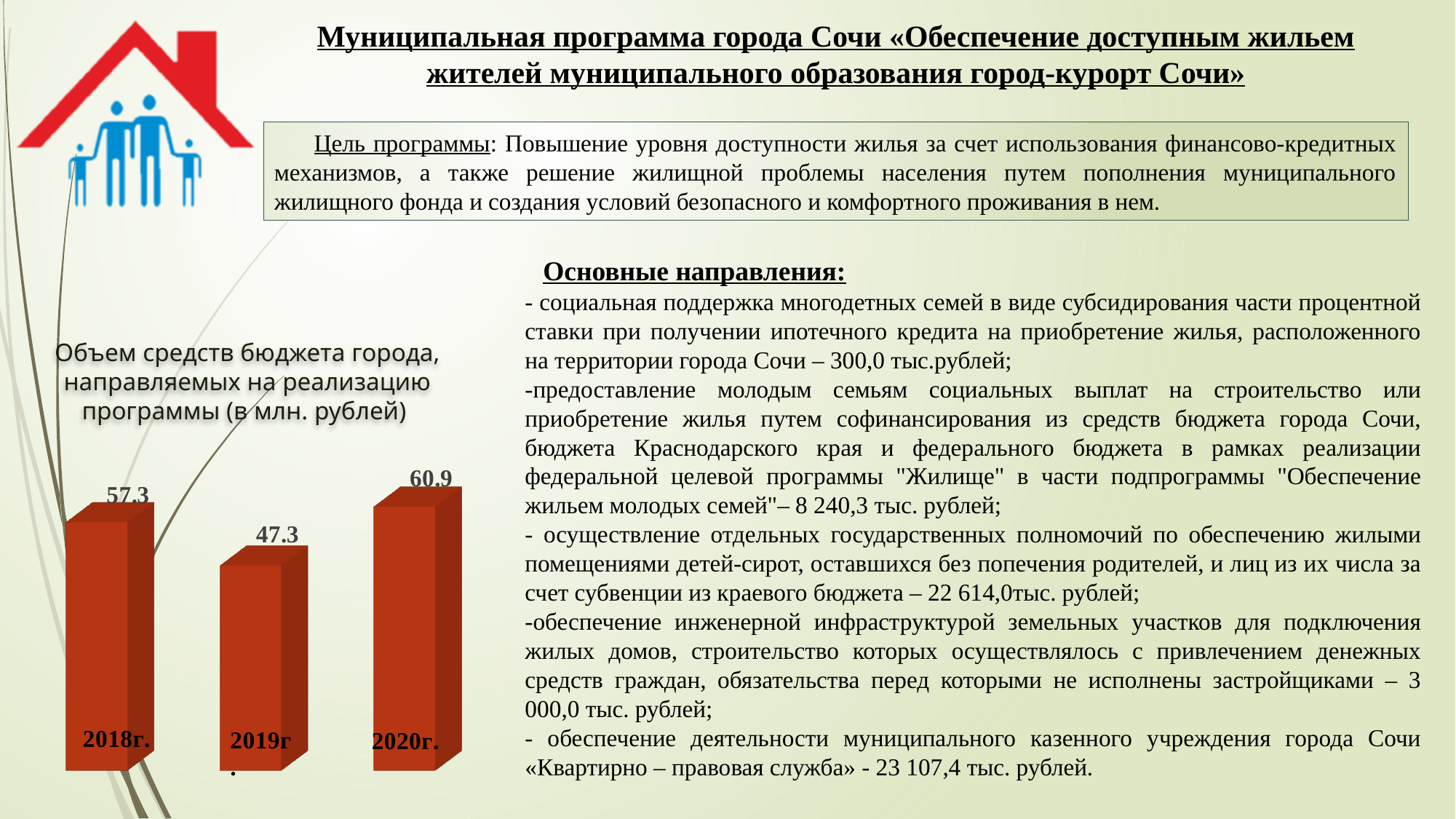
What is the value shown for 2020г. in the chart? 60.9 What is the value shown for 2018г. in the chart? 57.3 What type of chart is shown on the slide? bar chart How many bars are shown in the chart? 3 What is the value shown for 2019г. in the chart? 47.3 Which year has the highest value in the chart? 2020г. Which year has the lowest value in the chart? 2019г. Does the value fall or rise from 2018г. to 2019г.? fall In what units are the values in the chart expressed, according to its title? млн. рублей What is the difference between the values for 2018г. and 2019г.? 10 What is the difference between the values for 2020г. and 2019г.? 13.6 Which is larger, the value for 2018г. or the value for 2020г.? 2020г.